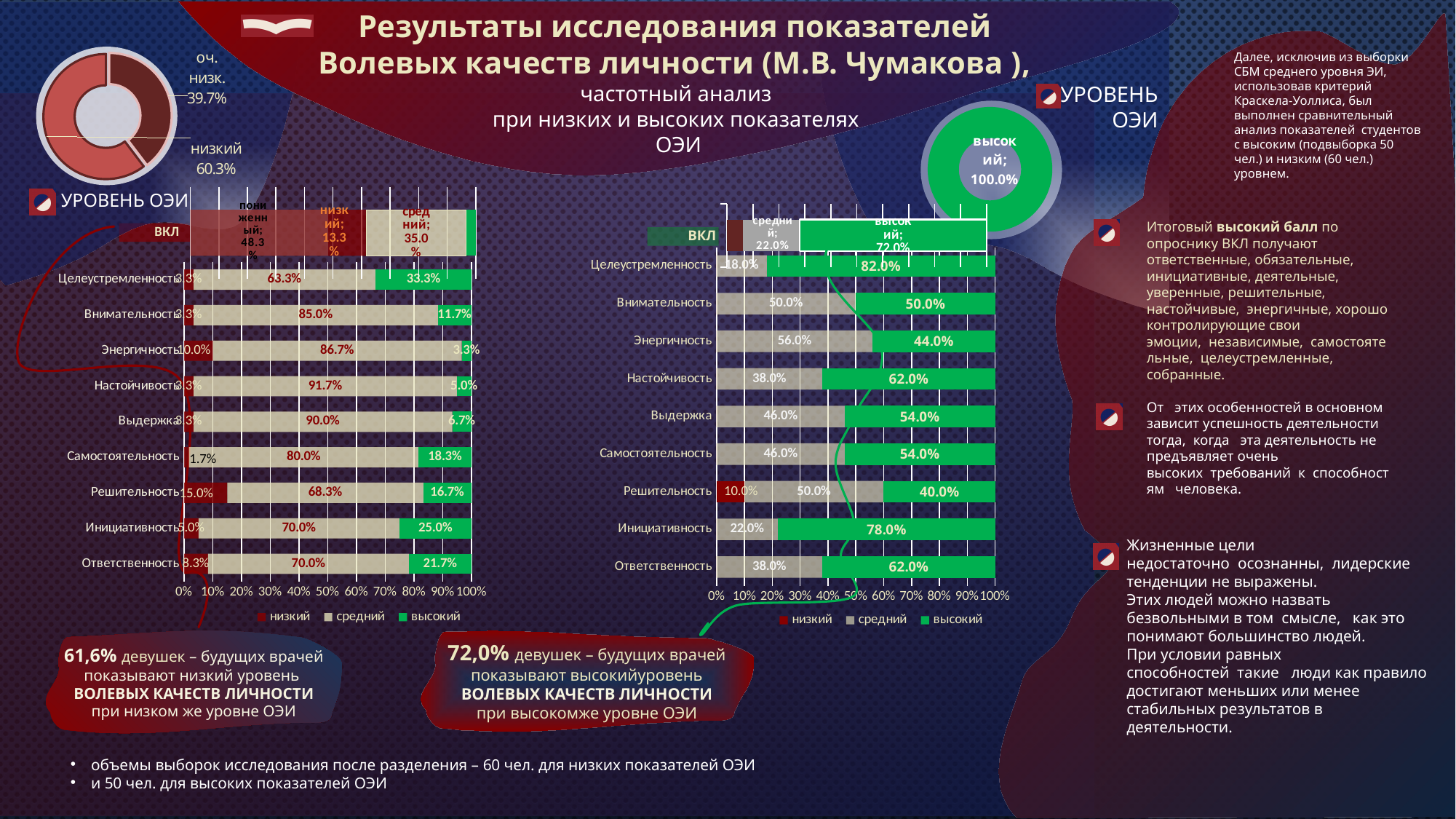
In the left stacked bar chart (low ОЭИ level), what is the value of the средний series for Настойчивость? 91.7% In the right stacked bar chart (high ОЭИ level), which is larger: the средний value for Энергичность or the средний value for Выдержка? Энергичность What type of chart is used for the two large charts in the middle of the slide? Stacked bar chart In the left stacked bar chart (low ОЭИ level), how many categories are shown on the vertical axis? 9 In the right stacked bar chart (high ОЭИ level), which category has the lowest value for the высокий series? Решительность In the left stacked bar chart (low ОЭИ level), what is the value of the высокий series for Целеустремленность? 33.3% In the left stacked bar chart (low ОЭИ level), how many series does the legend list? 3 In the right stacked bar chart (high ОЭИ level), what is the value of the высокий series for Инициативность? 78.0% In the left stacked bar chart (low ОЭИ level), which category has the highest value for the низкий series? Решительность In the right stacked bar chart (high ОЭИ level), which category has the highest value for the высокий series? Целеустремленность In the right stacked bar chart (high ОЭИ level), what is the difference between the высокий values for Настойчивость and Энергичность? 18.0% In the donut chart at the top left, what share is labelled низкий? 60.3%